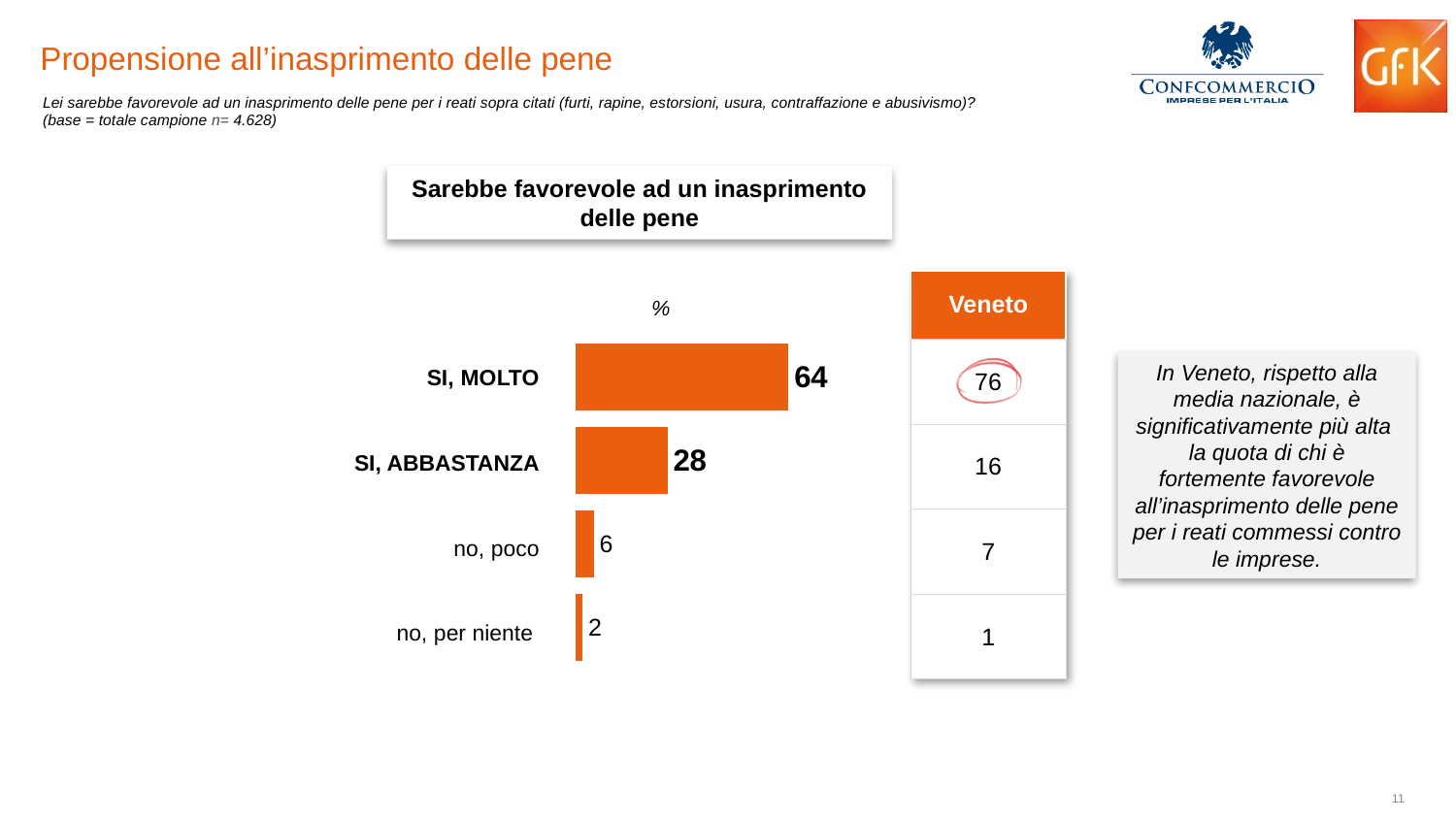
Which category has the highest value in the bar chart? SI, MOLTO Which category has the lowest value in the bar chart? no, per niente How many categories are shown in the bar chart? 4 What is the difference between the values for SI, MOLTO and SI, ABBASTANZA in the bar chart? 36 What is the value for no, poco in the bar chart? 6 What is the value for SI, ABBASTANZA in the bar chart? 28 What is the title shown above the bar chart? Sarebbe favorevole ad un inasprimento delle pene Which is larger in the bar chart: no, poco or no, per niente? no, poco What is the value for no, per niente in the bar chart? 2 What is the Veneto value for SI, MOLTO in the table next to the chart? 76 What is the value for SI, MOLTO in the bar chart? 64 What kind of chart is shown on the slide? Bar chart